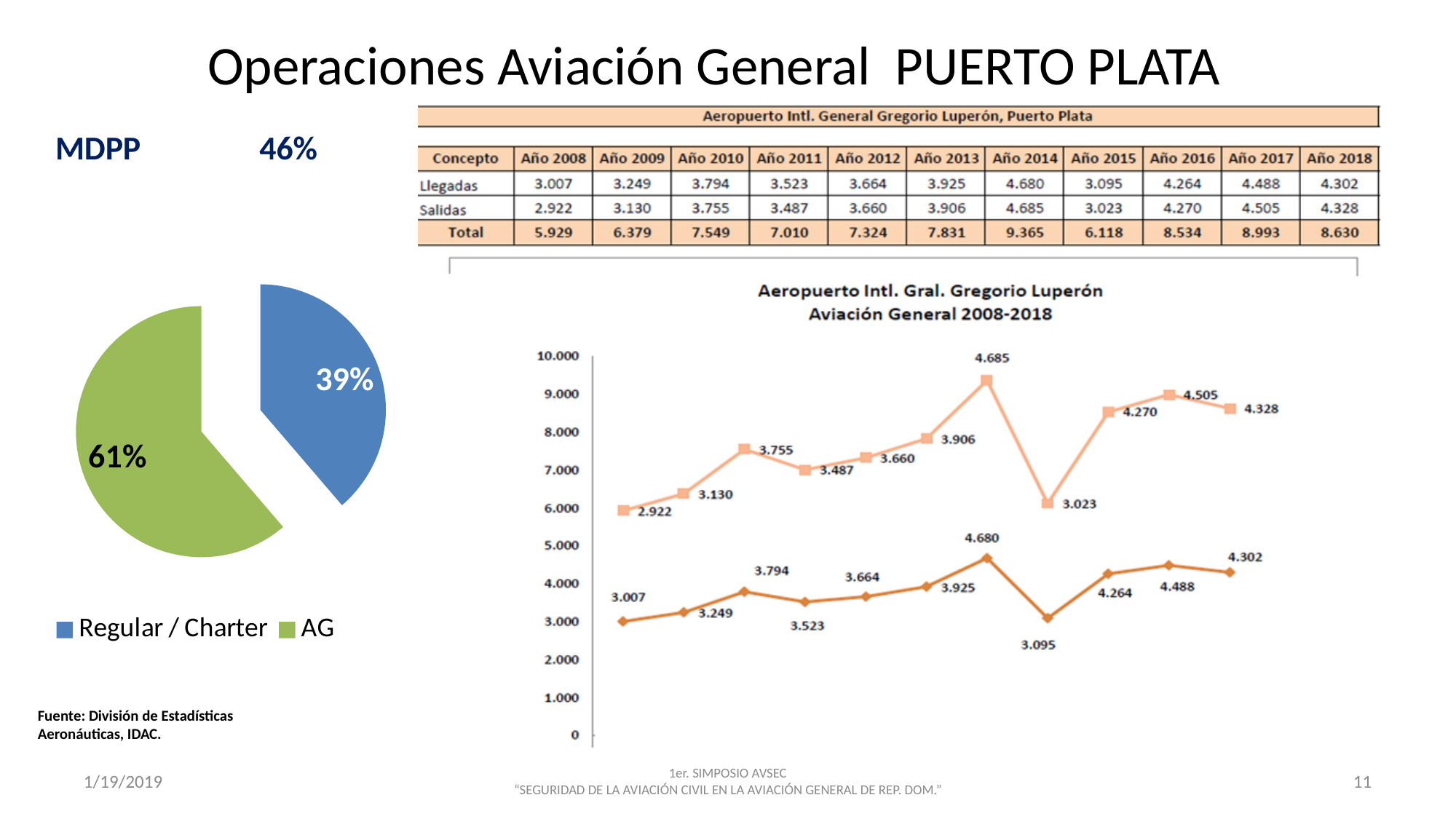
On the pie chart, what is the difference in percentage points between the AG slice and the Regular / Charter slice? 22 On the line chart, what is the highest labeled value on the upper (lighter) line? 4.685 On the line chart, what is the labeled value of the last point on the upper (lighter) line? 4.328 On the pie chart, what share does Regular / Charter have? 39% On the pie chart, what share does AG have? 61% On the pie chart, what colour is the AG slice? green On the line chart, how many data points does each line have? 11 How many slices does the pie chart have? 2 What kind of chart is the chart on the left of the slide? pie chart On the pie chart, which slice is larger, Regular / Charter or AG? AG What kind of chart is the chart titled 'Aeropuerto Intl. Gral. Gregorio Luperón Aviación General 2008-2018'? line chart On the line chart, what is the lowest labeled value on the lower (darker) line? 3.007